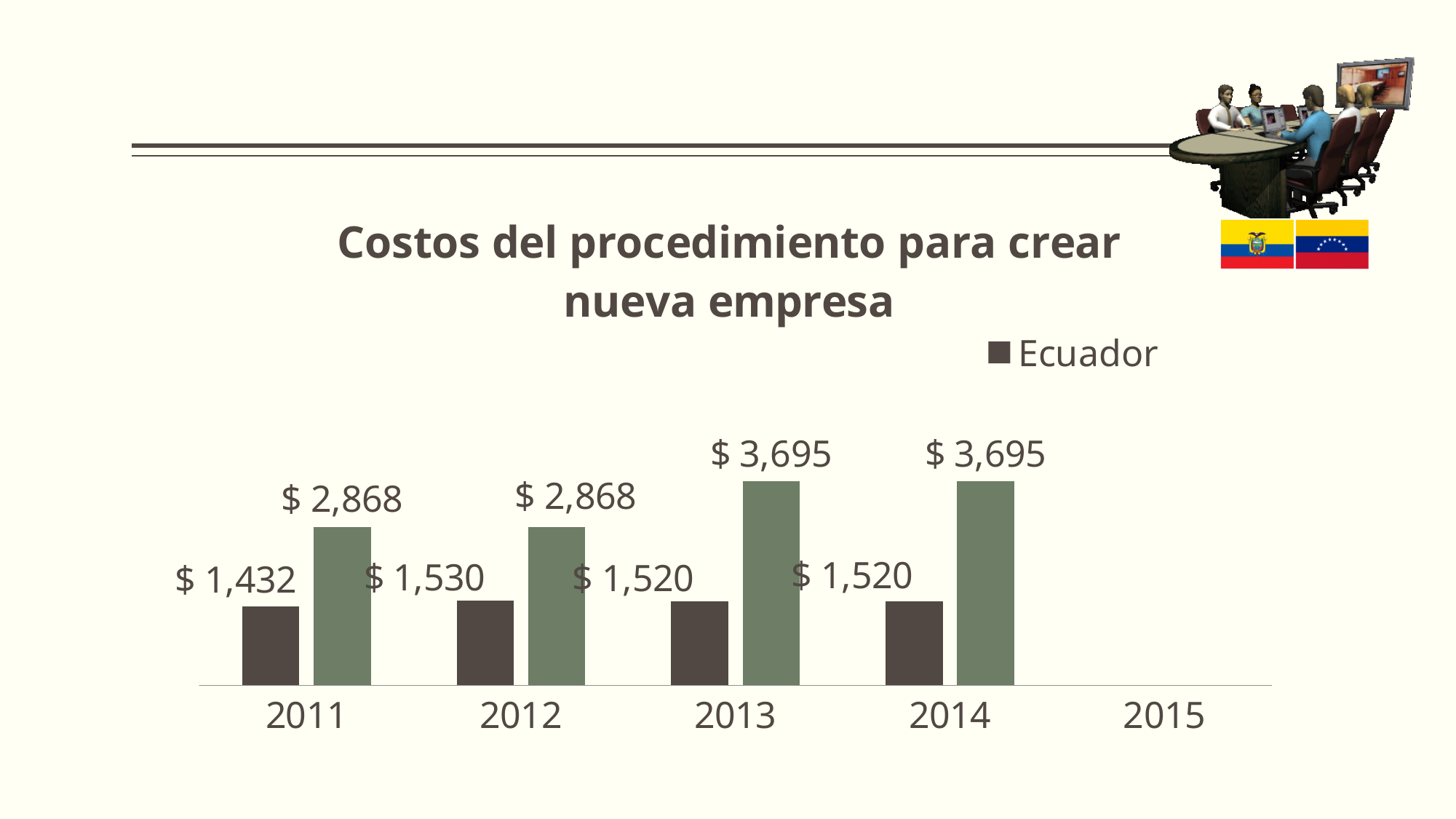
What is the difference between the Ecuador values for 2012 and 2011? $ 98 In which year is the Ecuador value highest? 2012 In which year is the Ecuador value lowest? 2011 How many series does the legend list? 1 What is the value for Ecuador in 2014? $ 1,520 In 2013, what is the difference between the green bar and the Ecuador bar? $ 2,175 What kind of chart is shown on the slide? Bar chart What is the value for Ecuador in 2012? $ 1,530 What is the value for Ecuador in 2011? $ 1,432 How many years are shown on the x axis? 5 What value is labelled on the green bar for 2013? $ 3,695 Which is larger, the Ecuador value for 2011 or for 2012? 2012